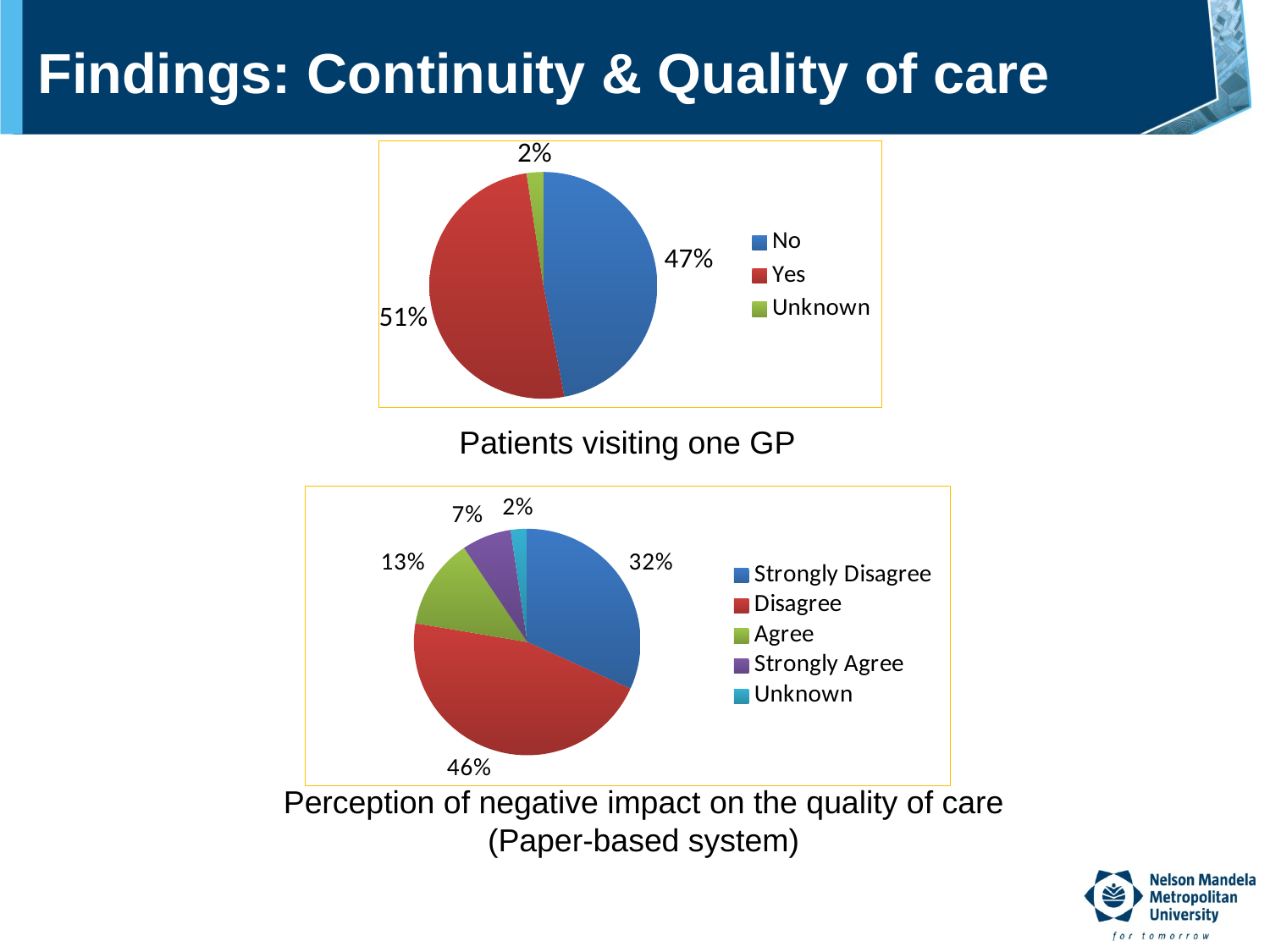
In the 'Patients visiting one GP' chart, what share of patients answered Yes? 51% In the 'Patients visiting one GP' chart, what is the difference between the Yes and No shares? 4% In the 'Patients visiting one GP' chart, what share of patients answered No? 47% In the 'Perception of negative impact on the quality of care (Paper-based system)' chart, which category has the largest slice? Disagree In the 'Patients visiting one GP' chart, how many categories does the legend list? 3 In the 'Perception of negative impact on the quality of care (Paper-based system)' chart, what colour is the Agree slice? Green In the 'Perception of negative impact on the quality of care (Paper-based system)' chart, which is larger: Agree or Strongly Disagree? Strongly Disagree In the 'Perception of negative impact on the quality of care (Paper-based system)' chart, what share is Strongly Agree? 7% In the 'Perception of negative impact on the quality of care (Paper-based system)' chart, how many categories does the legend list? 5 In the 'Patients visiting one GP' chart, which category has the smallest slice? Unknown What kind of chart is the 'Patients visiting one GP' chart? Pie chart